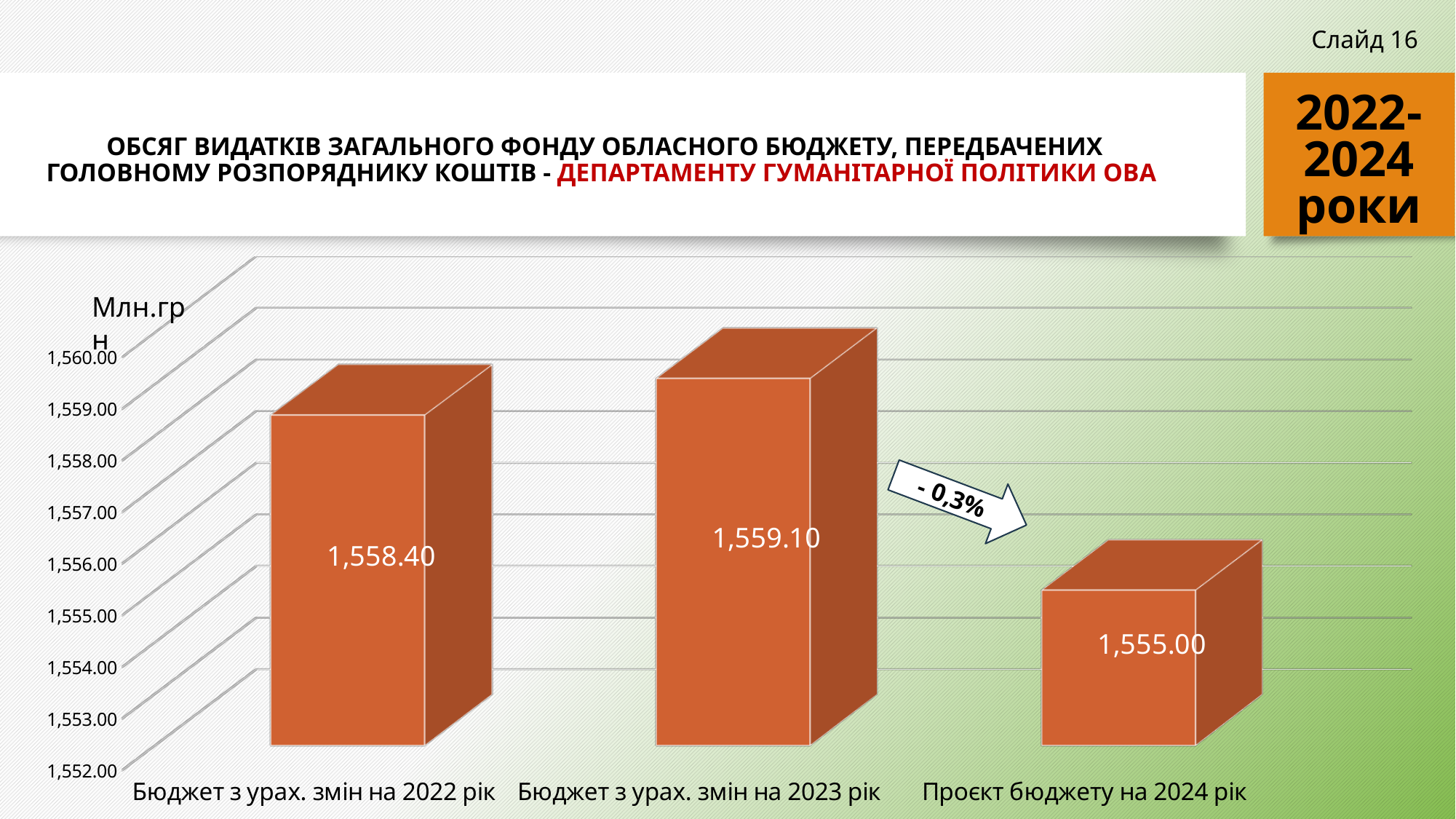
How many categories are shown on the chart? 3 Which is larger, the value for 2022 or the value for 2024? 2022 What is the value for "Проєкт бюджету на 2024 рік"? 1,555.00 What is the value for "Бюджет з урах. змін на 2023 рік"? 1,559.10 What is the value for "Бюджет з урах. змін на 2022 рік"? 1,558.40 Which category has the lowest value? Проєкт бюджету на 2024 рік What is the difference between the values for 2023 and 2022? 0.70 What is the difference between the values for 2023 and 2024? 4.10 Which category has the highest value? Бюджет з урах. змін на 2023 рік What kind of chart is shown on the slide? bar chart What percentage change is shown on the arrow between the 2023 and 2024 bars? - 0,3% Is the value for "Проєкт бюджету на 2024 рік" greater or less than 1,556.00? less